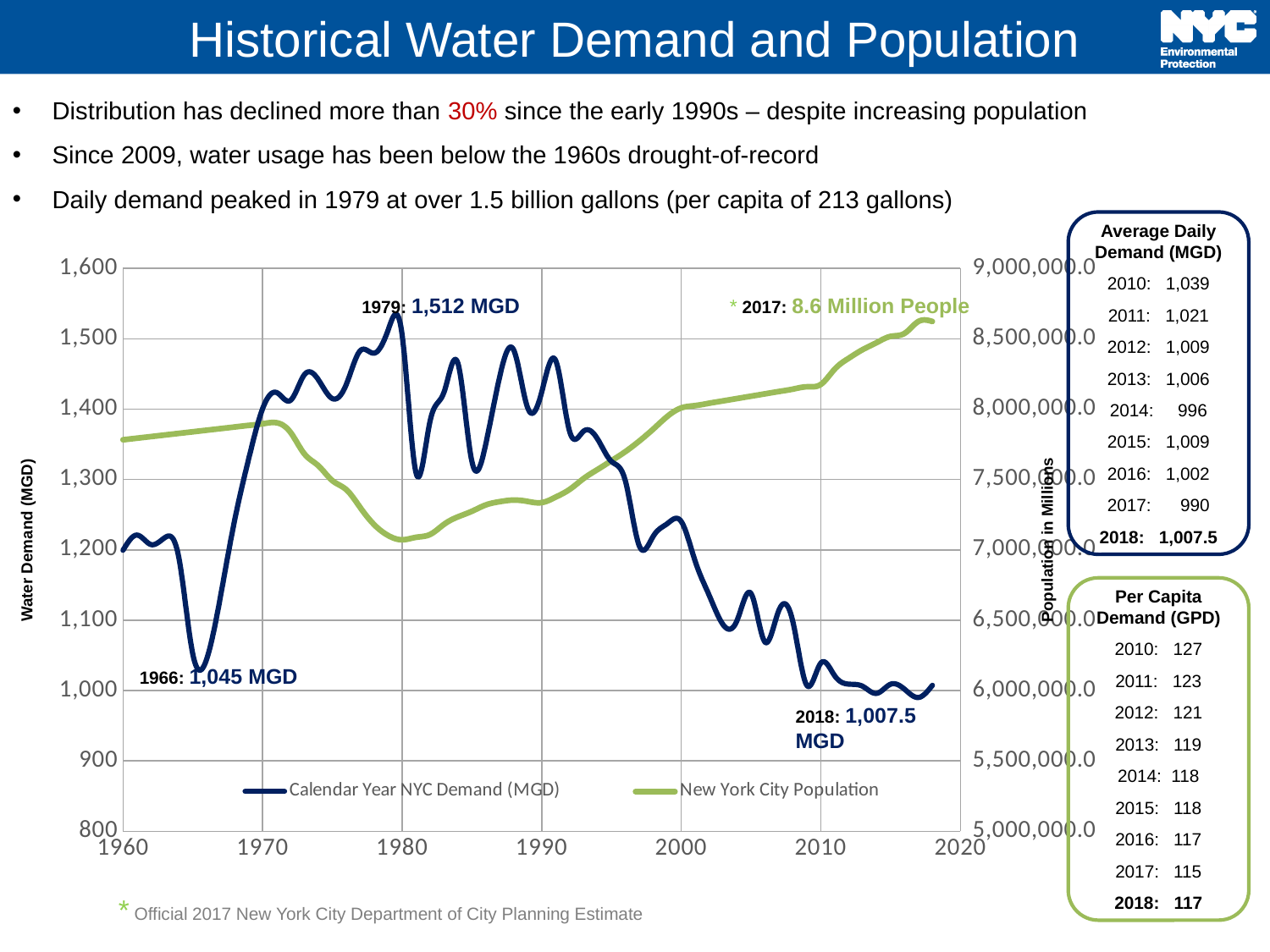
What was the Calendar Year NYC Demand (MGD) in 1979, as labelled on the chart? 1,512 MGD What kind of chart is shown on the slide? line chart What was the Calendar Year NYC Demand (MGD) in 1966, as labelled on the chart? 1,045 MGD How many series does the chart legend list? 2 Is the Calendar Year NYC Demand (MGD) in 1960 greater or less than 1,100? greater What is the difference between the labelled demand in 1979 and the labelled demand in 1966? 467 MGD Which labelled demand value is larger: 1966 or 2018? 1966 Is the New York City Population in 1960 greater or less than 8,000,000.0? less What was the Calendar Year NYC Demand (MGD) in 2018, as labelled on the chart? 1,007.5 MGD In which year did the Calendar Year NYC Demand (MGD) line reach its highest point? 1979 Does the New York City Population line rise or fall between 1980 and 2017? rise What was the New York City Population in 2017, as labelled on the chart? 8.6 Million People